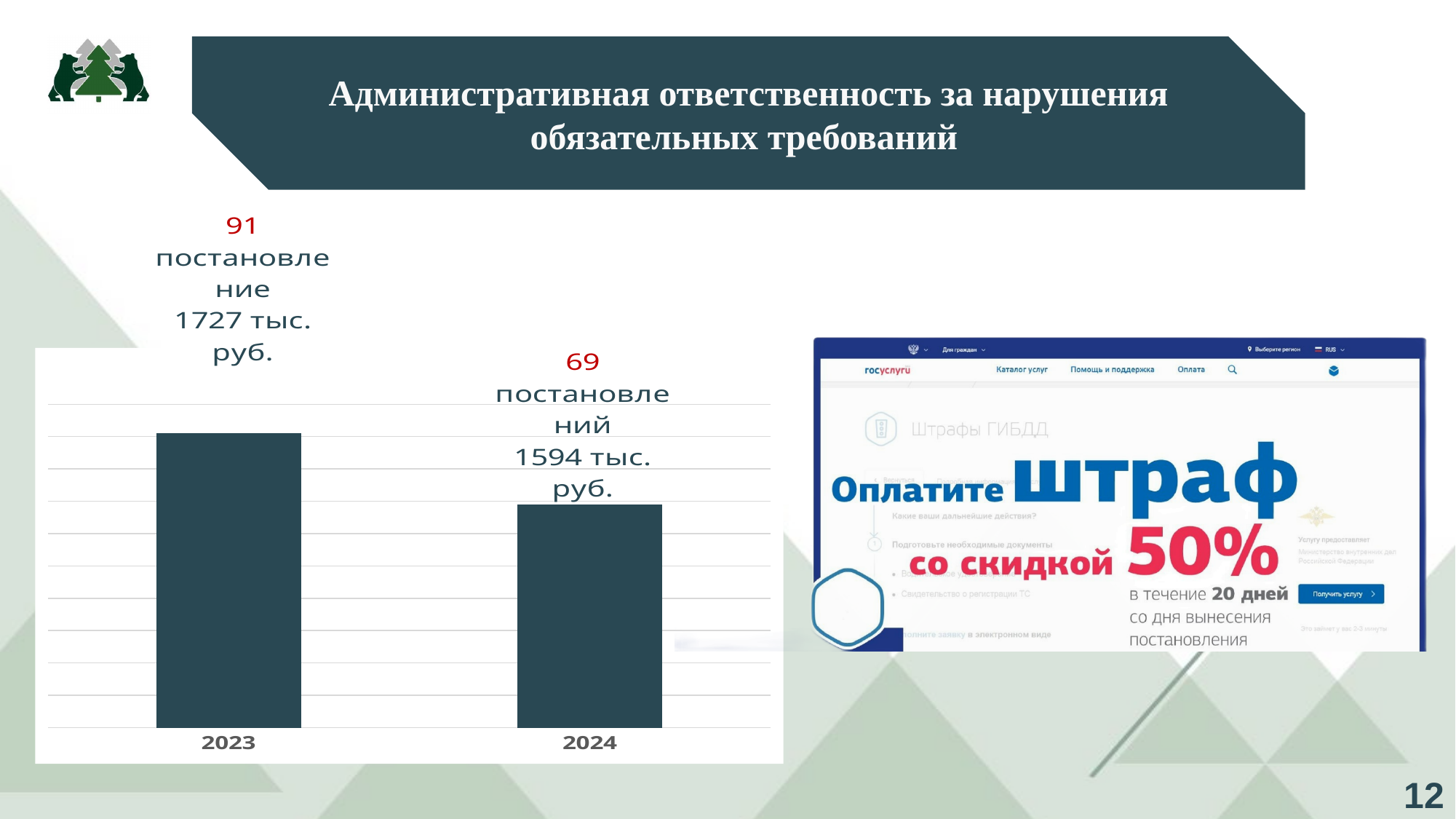
Which year has the shorter bar? 2024 By how many постановлений does 2023 exceed 2024? 22 What amount in тыс. руб. is shown in the data label for 2023? 1727 тыс. руб. What kind of chart is shown on the slide? Bar chart Is the number of постановлений larger in 2023 or in 2024? 2023 What is the difference in тыс. руб. between the 2023 and 2024 amounts? 133 тыс. руб. How many years (categories) are shown on the chart? 2 What amount in тыс. руб. is shown in the data label for 2024? 1594 тыс. руб. How many постановлений does the data label show for 2024? 69 How many постановлений does the data label show for 2023? 91 Which year has the taller bar? 2023 Do the values rise or fall from 2023 to 2024? Fall